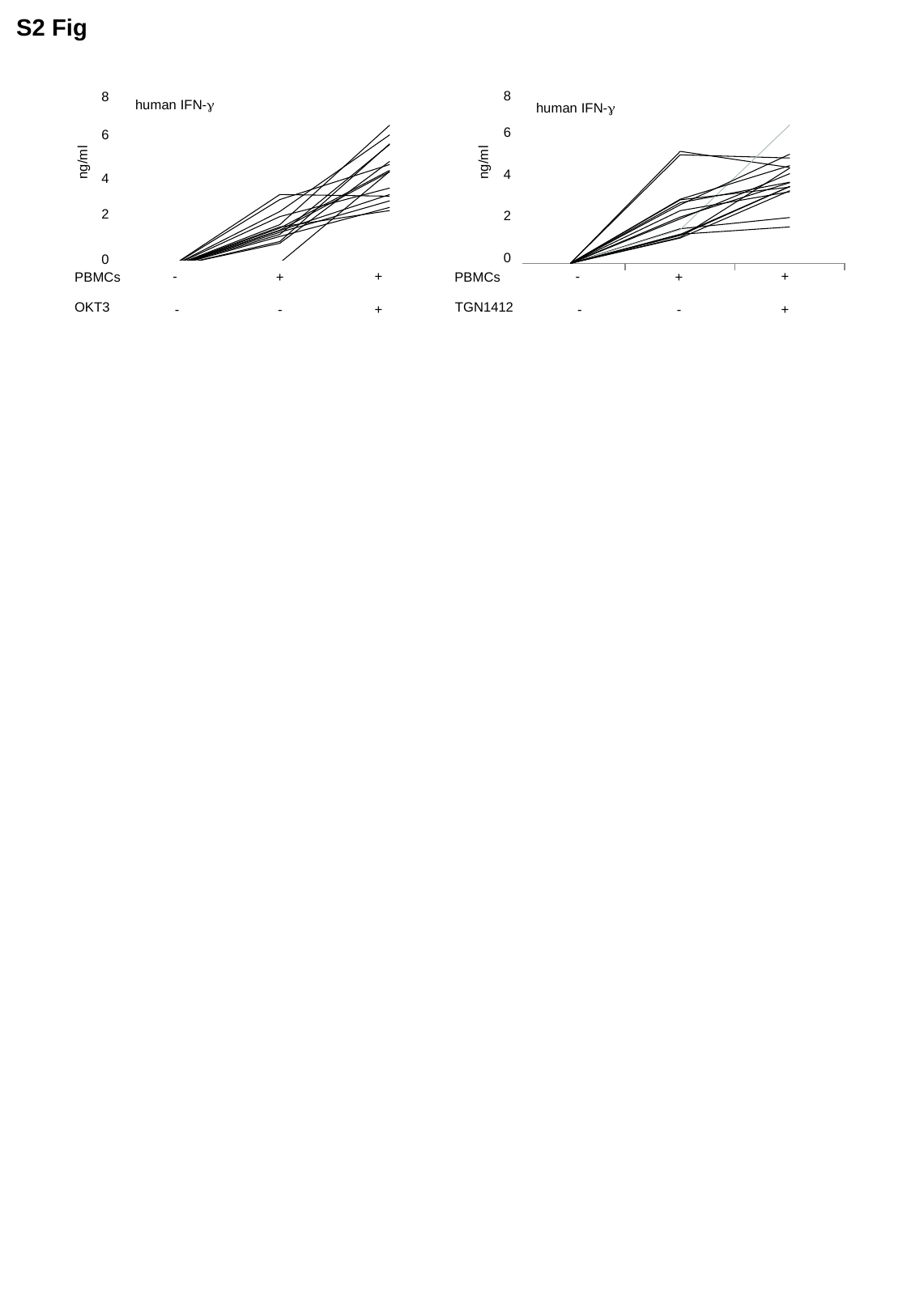
What is the title shown on both charts? human IFN-γ In the left chart (OKT3), is the highest line at the middle condition (PBMCs +, OKT3 -) greater or less than 4? less How many x-axis conditions are plotted in the left chart (OKT3)? 3 How many x-axis conditions are plotted in the right chart (TGN1412)? 3 In the left chart (OKT3), what is the value of the lines at the first condition (PBMCs -, OKT3 -)? 0 In the left chart (OKT3), do the lines generally rise or fall from the first condition to the last condition? rise In the right chart (TGN1412), is the highest line at the middle condition (PBMCs +, TGN1412 -) greater or less than 4? greater What kind of chart is the left chart (OKT3)? line chart In the right chart (TGN1412), is the lowest line at the last condition (PBMCs +, TGN1412 +) greater or less than 2? less In the right chart (TGN1412), what is the value of the lines at the first condition (PBMCs -, TGN1412 -)? 0 What unit is shown on the y axis of the left chart (OKT3)? ng/ml What kind of chart is the right chart (TGN1412)? line chart